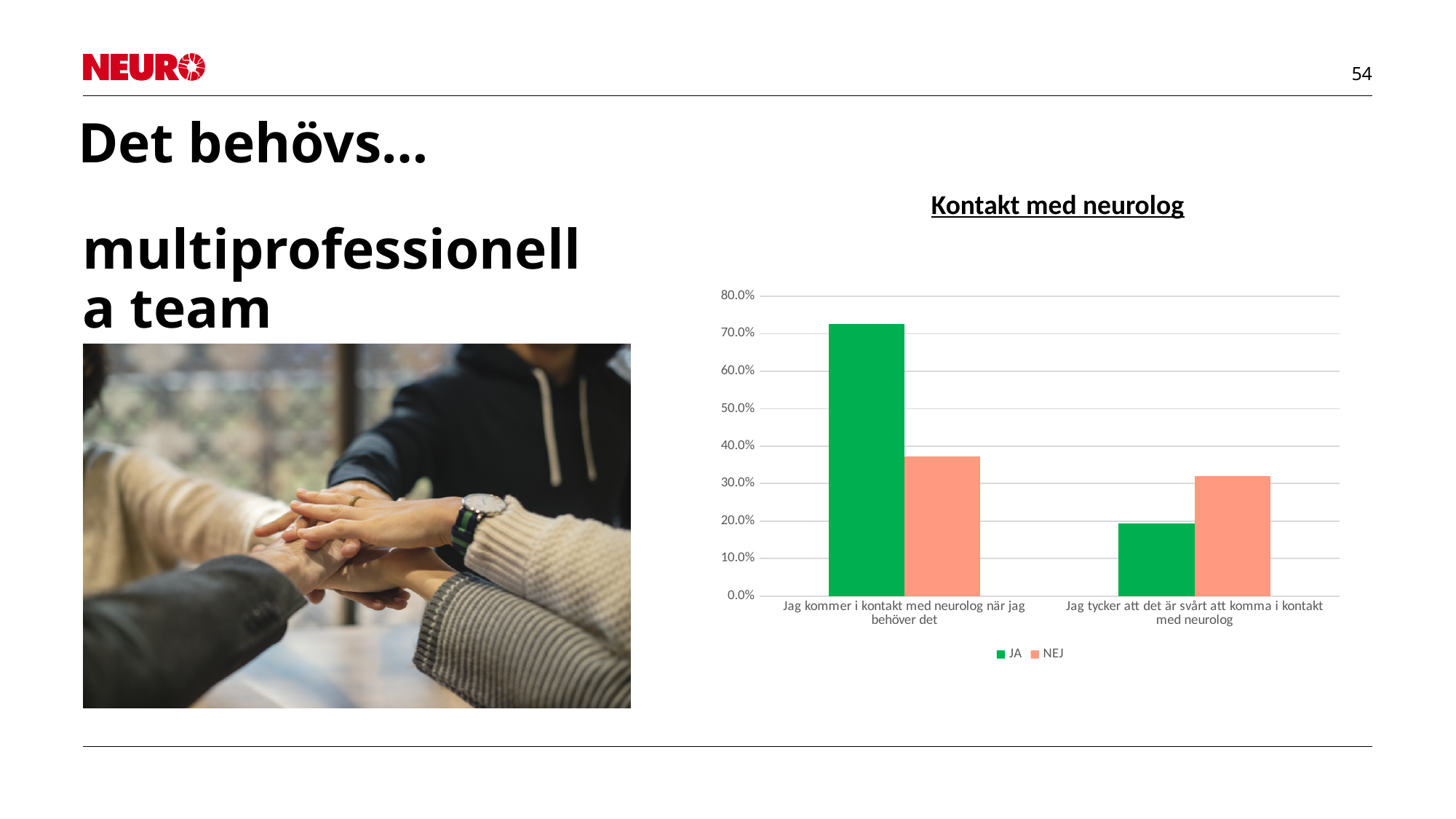
In the "Kontakt med neurolog" chart, is the JA value for "Jag tycker att det är svårt att komma i kontakt med neurolog" greater or less than 30.0%? less How many series does the legend of the "Kontakt med neurolog" chart list? 2 In the "Kontakt med neurolog" chart, is the NEJ value for "Jag kommer i kontakt med neurolog när jag behöver det" greater or less than 40.0%? less In the "Kontakt med neurolog" chart, which bar is the tallest overall? JA for "Jag kommer i kontakt med neurolog när jag behöver det" In the "Kontakt med neurolog" chart, which series has the larger value for "Jag kommer i kontakt med neurolog när jag behöver det", JA or NEJ? JA In the "Kontakt med neurolog" chart, which series has the larger value for "Jag tycker att det är svårt att komma i kontakt med neurolog", JA or NEJ? NEJ What colour are the JA bars in the "Kontakt med neurolog" chart? green In the "Kontakt med neurolog" chart, is the JA value for "Jag kommer i kontakt med neurolog när jag behöver det" greater or less than 70.0%? greater What kind of chart is shown under the title "Kontakt med neurolog"? bar chart How many categories are shown on the x axis of the "Kontakt med neurolog" chart? 2